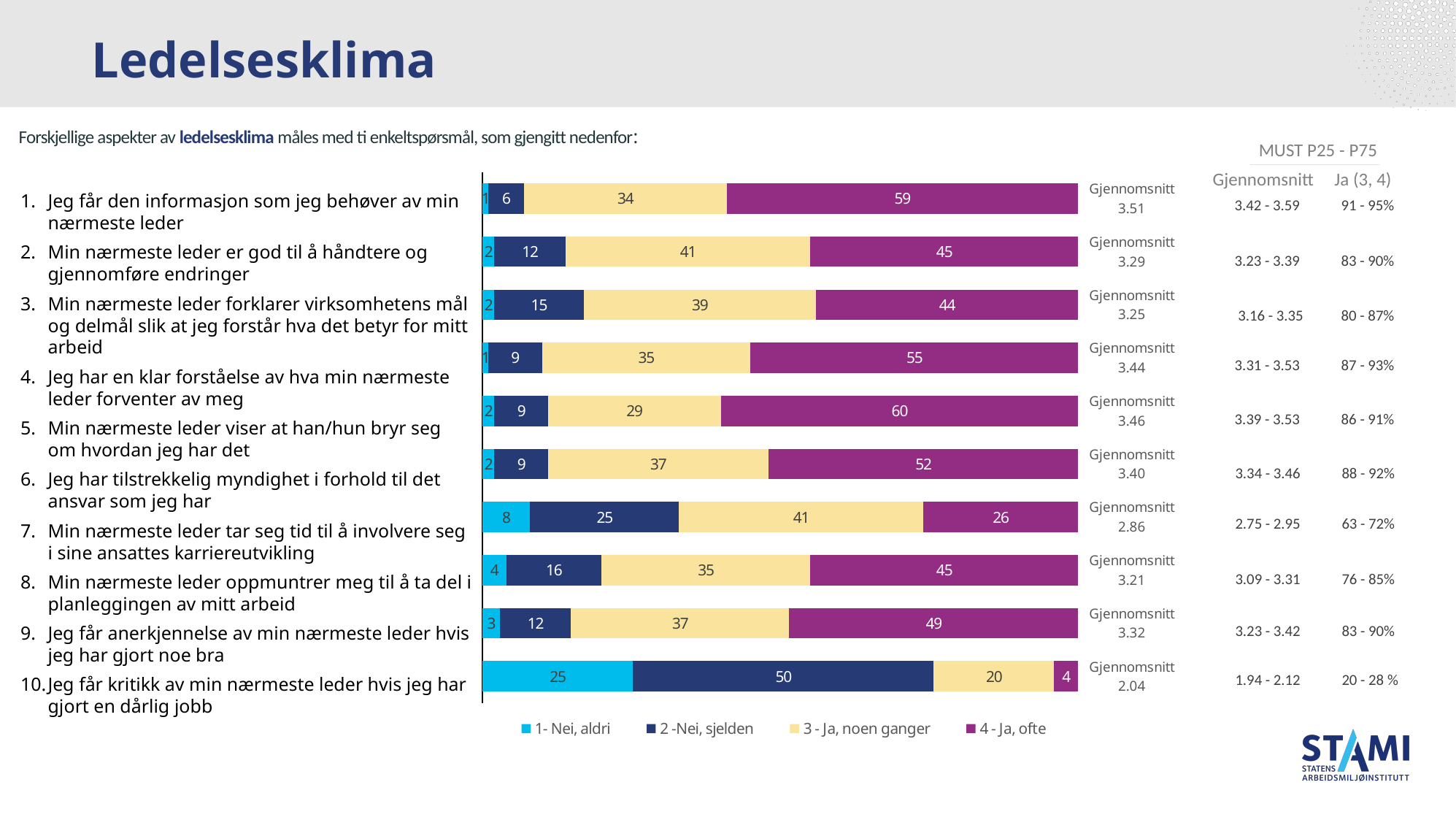
What is the value of '2 - Nei, sjelden' for statement 7, 'Min nærmeste leder tar seg tid til å involvere seg i sine ansattes karriereutvikling'? 25 Which statement has the lowest value for '4 - Ja, ofte'? Statement 10 (Jeg får kritikk av min nærmeste leder hvis jeg har gjort en dårlig jobb) Which statement has the highest value for '4 - Ja, ofte'? Statement 5 (Min nærmeste leder viser at han/hun bryr seg om hvordan jeg har det) Which is larger: the '3 - Ja, noen ganger' value for statement 2 or for statement 5? Statement 2 What is the value of '4 - Ja, ofte' for statement 1, 'Jeg får den informasjon som jeg behøver av min nærmeste leder'? 59 What is the difference between the '4 - Ja, ofte' values for statement 5 and statement 7? 34 How many statements (bars) are plotted in the chart? 10 What is the value of '1 - Nei, aldri' for statement 10, 'Jeg får kritikk av min nærmeste leder hvis jeg har gjort en dårlig jobb'? 25 What is the total of the four segments in the bar for statement 10? 99 What kind of chart is shown on the slide? Stacked bar chart How many series does the chart legend list? 4 Which legend entry is shown in light blue? 1- Nei, aldri